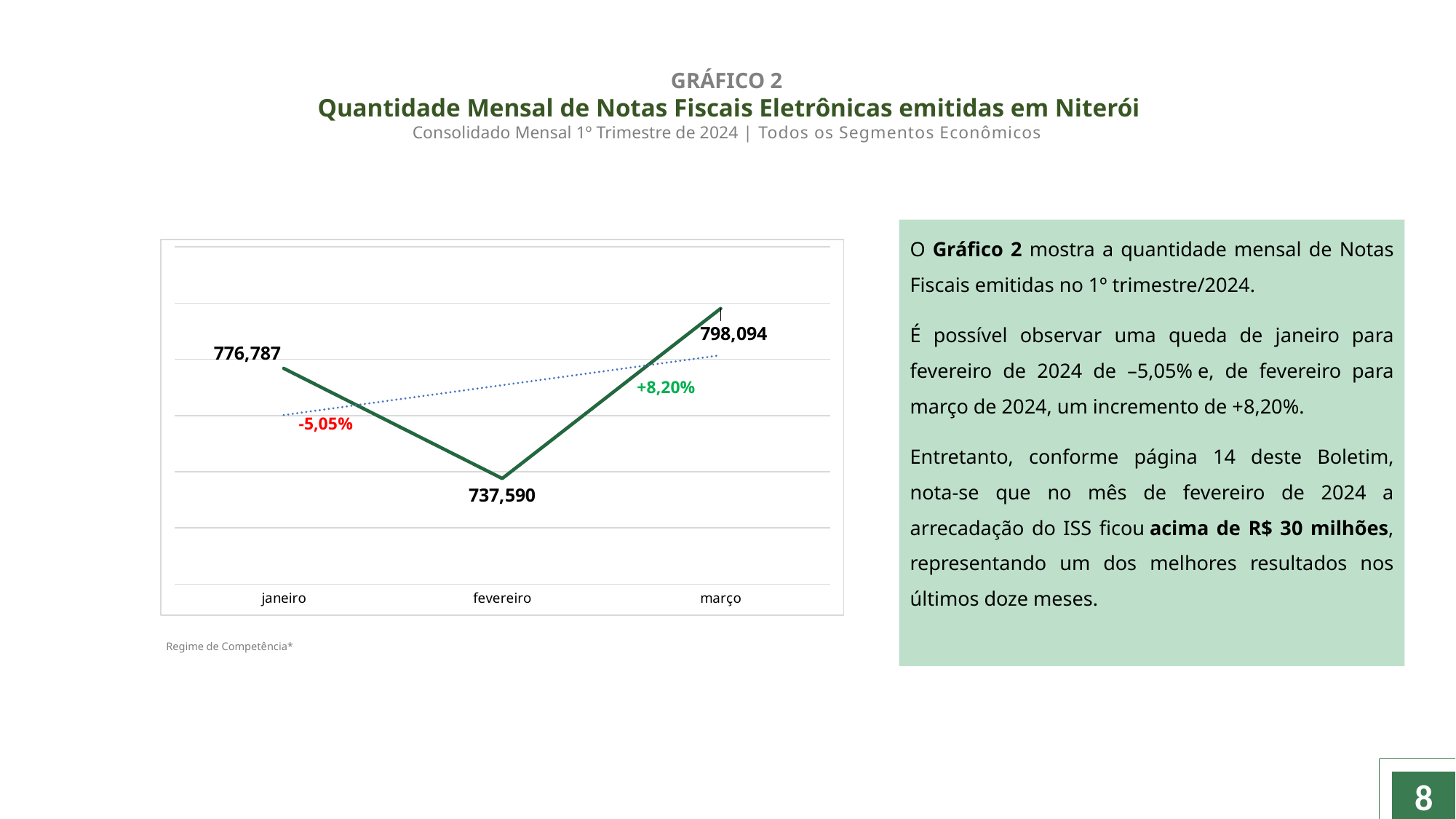
How many months are plotted on the chart? 3 Which is larger, the value for janeiro or the value for março? março What is the difference between the values for janeiro and fevereiro? 39,197 Which month has the lowest value? fevereiro Which month has the highest value? março What kind of chart is shown? line chart What percentage change is labelled between fevereiro and março? +8,20% What is the difference between the values for março and fevereiro? 60,504 What is the value for março? 798,094 What is the value for janeiro? 776,787 What is the value for fevereiro? 737,590 What percentage change is labelled between janeiro and fevereiro? -5,05%